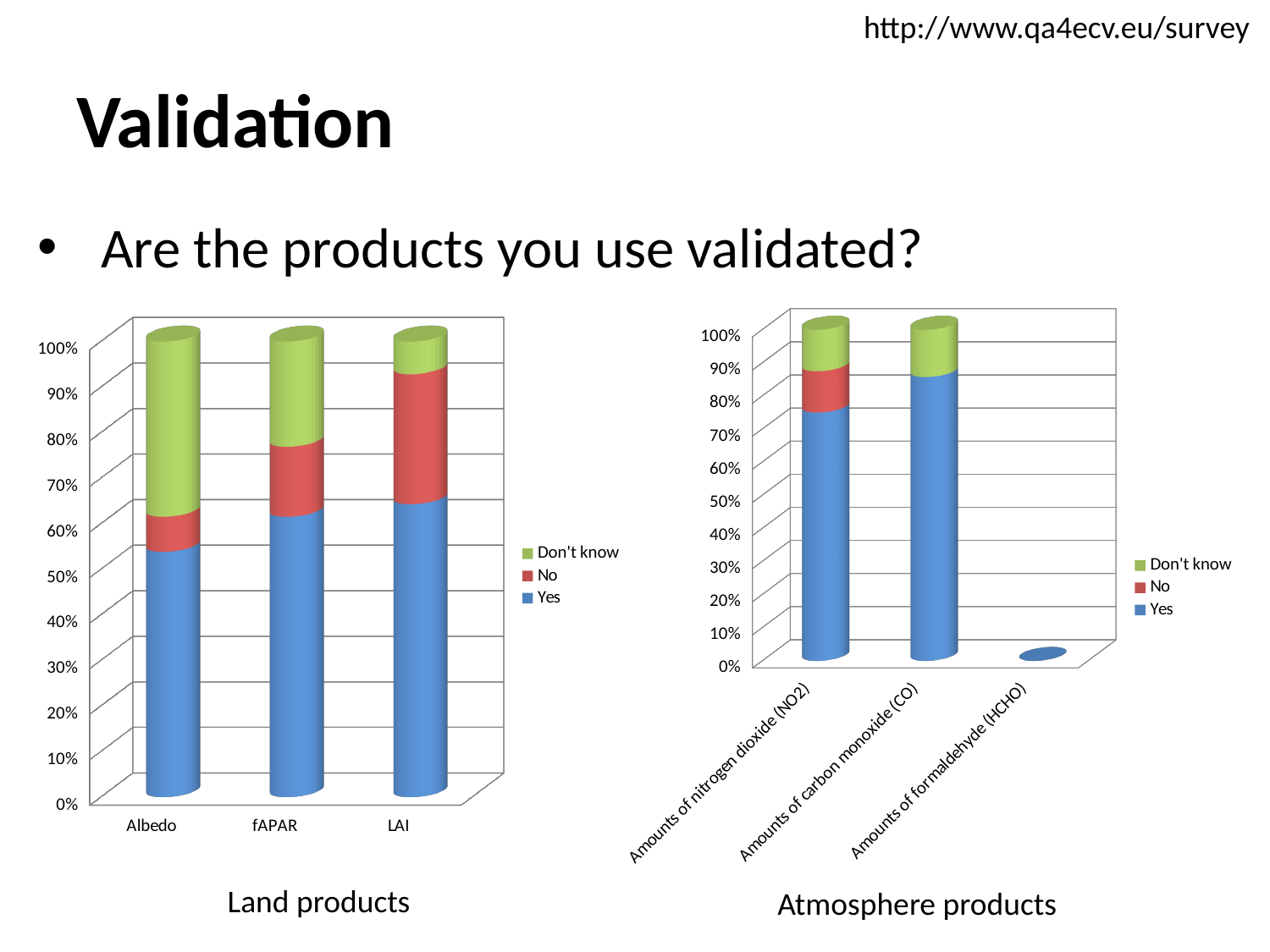
In the Atmosphere products chart, is the 'Yes' share for Amounts of carbon monoxide (CO) greater or less than 80%? greater In the Atmosphere products chart, which category has no visible bar? Amounts of formaldehyde (HCHO) In the Land products chart, is the 'Don't know' share for LAI greater or less than 20%? less What are the legend entries of the Atmosphere products chart? Don't know, No, Yes How many categories are shown on the x axis of the Land products chart? 3 How many categories are shown on the x axis of the Atmosphere products chart? 3 In the Land products chart, which product has the largest 'Don't know' share? Albedo How many series does the legend of the Land products chart list? 3 In the Land products chart, which product has the largest 'No' share? LAI In the Land products chart, is the 'Yes' share larger for Albedo or for LAI? LAI What kind of chart is the Land products chart? Stacked bar chart In the Land products chart, is the 'Yes' share for Albedo greater or less than 50%? greater